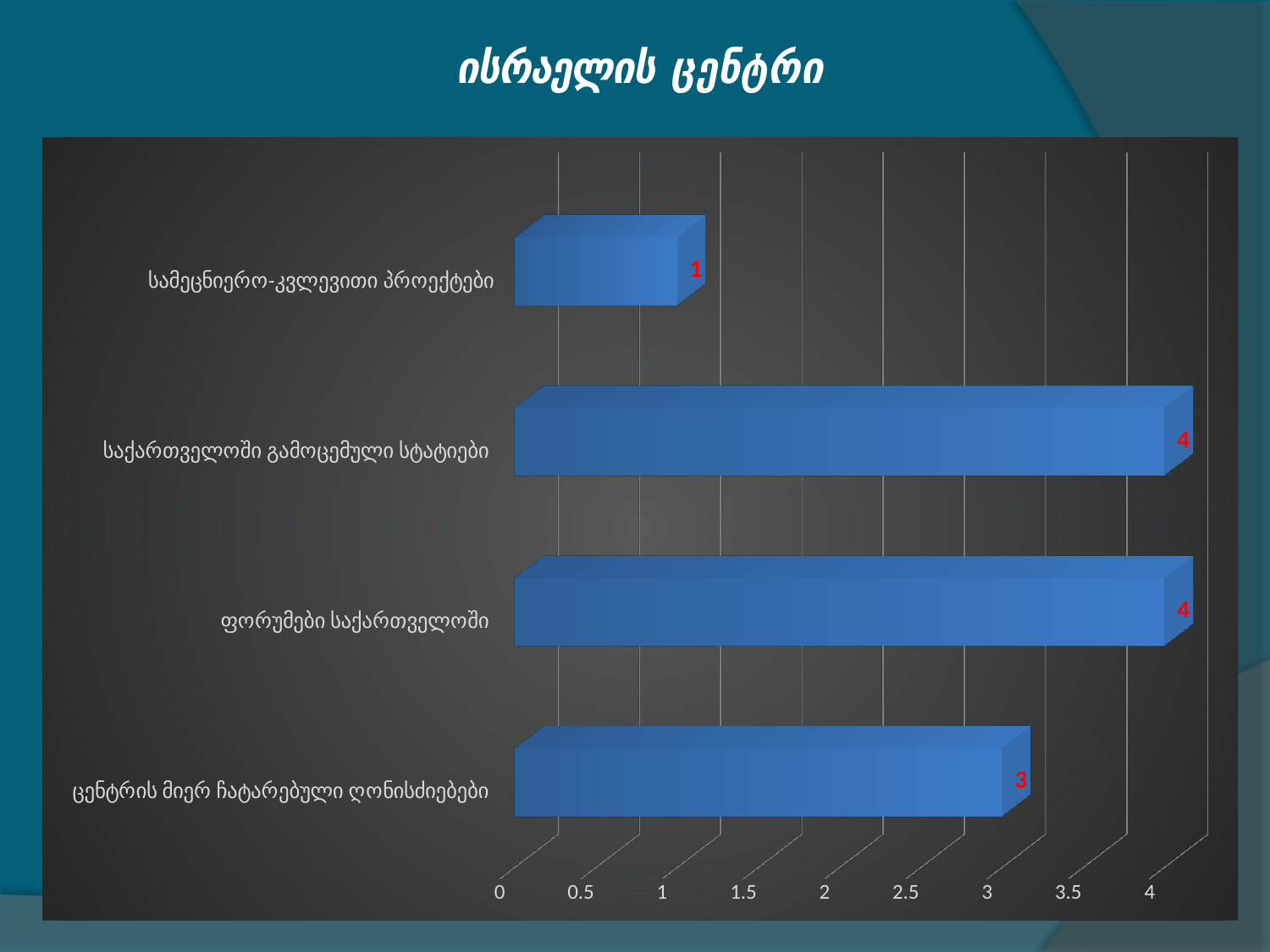
What is the value for სამეცნიერო-კვლევითი პროექტები? 1 How many categories are shown in the chart? 4 Which category has the lowest value? სამეცნიერო-კვლევითი პროექტები What is the difference between the values for საქართველოში გამოცემული სტატიები and ცენტრის მიერ ჩატარებული ღონისძიებები? 1 What is the value for ცენტრის მიერ ჩატარებული ღონისძიებები? 3 Which is larger: the value for ცენტრის მიერ ჩატარებული ღონისძიებები or the value for სამეცნიერო-კვლევითი პროექტები? ცენტრის მიერ ჩატარებული ღონისძიებები What is the value for ფორუმები საქართველოში? 4 What kind of chart is shown on the slide? bar chart Is the value for ცენტრის მიერ ჩატარებული ღონისძიებები greater or less than 2? greater What is the value for საქართველოში გამოცემული სტატიები? 4 What is the difference between the values for ფორუმები საქართველოში and სამეცნიერო-კვლევითი პროექტები? 3 What is the title of the slide? ისრაელის ცენტრი